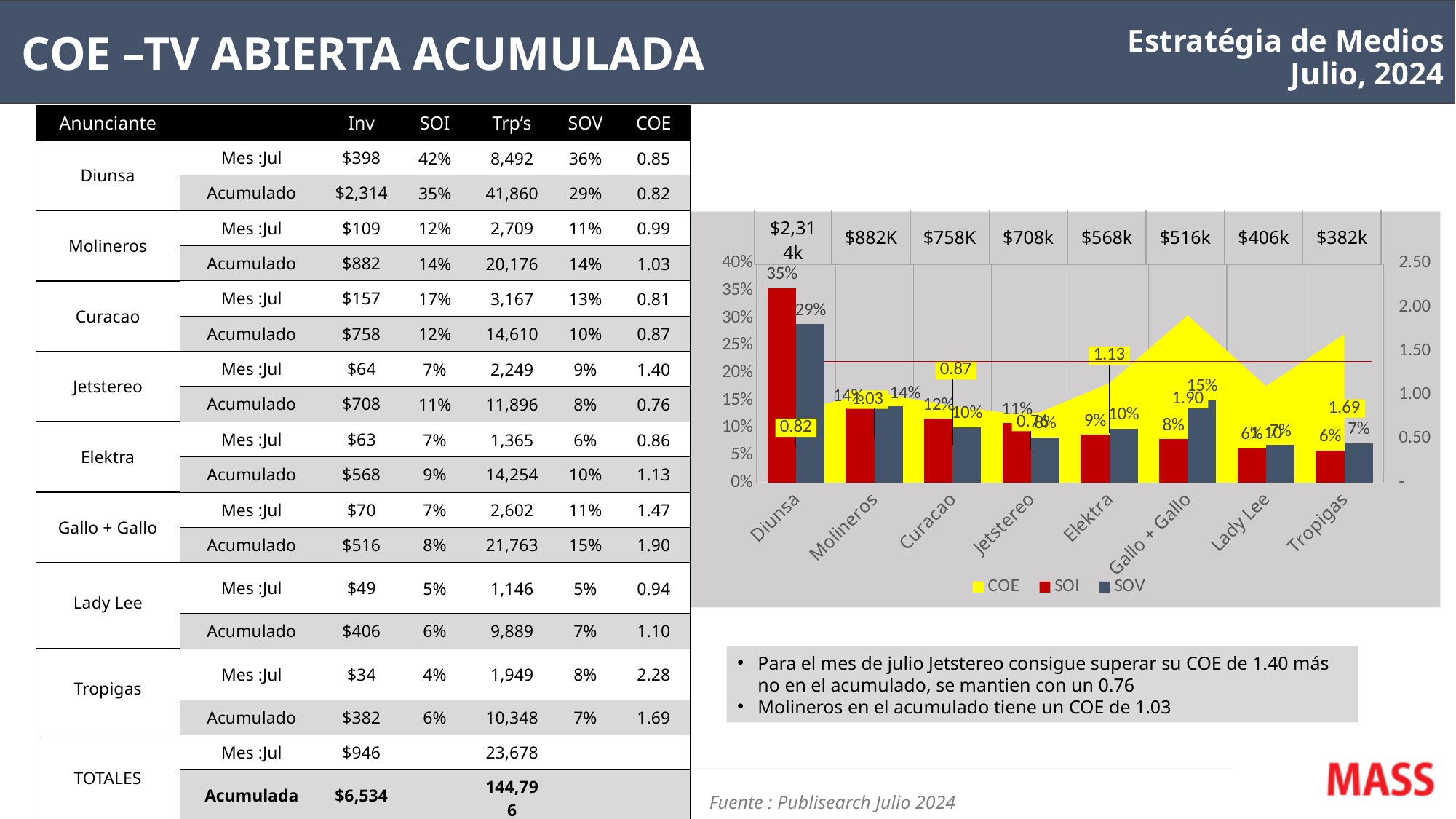
What is the SOI value for Diunsa in the chart? 35% How many series does the chart legend list? 3 Which is larger for Gallo + Gallo in the chart, SOI or SOV? SOV Which advertiser has the highest SOI in the chart? Diunsa What is the difference between the SOI and SOV values for Diunsa in the chart? 6% How many advertisers are shown on the x axis of the chart? 8 What is the SOV value for Gallo + Gallo in the chart? 15% Which series in the chart is shown in yellow? COE What COE value is labelled for Gallo + Gallo in the chart? 1.90 Is the SOI value for Diunsa greater or less than 30%? greater Which advertiser has the highest COE in the chart? Gallo + Gallo What COE value is labelled for Elektra in the chart? 1.13